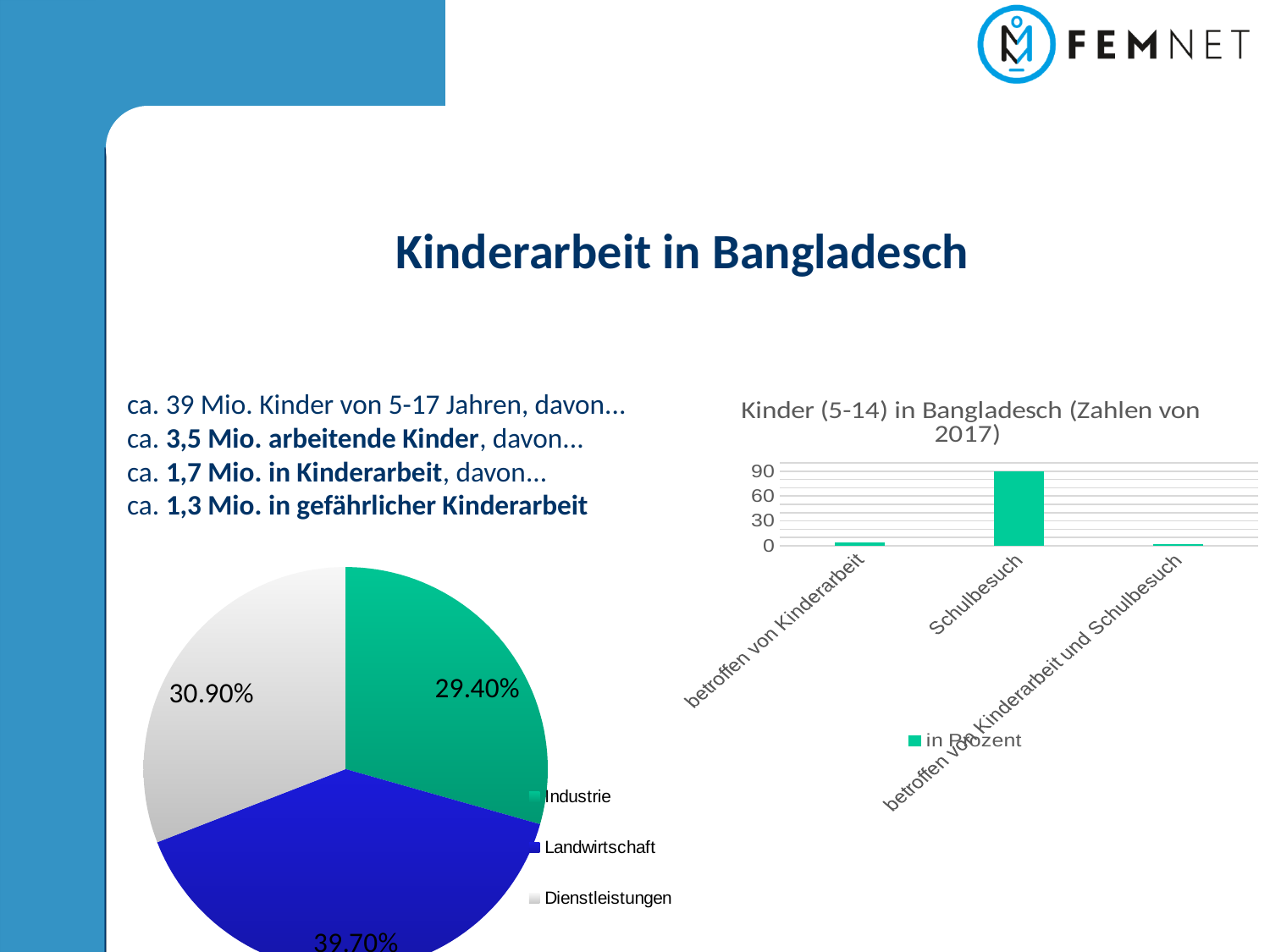
How many slices does the pie chart on the left have? 3 In the pie chart on the left, what percentage is shown for Landwirtschaft? 39.70% In the pie chart on the left, which category has the smallest share? Industrie What kind of chart is the chart on the left of the slide? Pie chart In the pie chart on the left, what is the difference between the shares of Landwirtschaft and Dienstleistungen? 8.80% In the pie chart on the left, which category has the largest share? Landwirtschaft In the chart 'Kinder (5-14) in Bangladesch (Zahlen von 2017)', is the value for Schulbesuch greater or less than 60? greater How many series does the legend of the chart 'Kinder (5-14) in Bangladesch (Zahlen von 2017)' list? 1 In the pie chart on the left, what percentage is shown for Industrie? 29.40% What kind of chart is 'Kinder (5-14) in Bangladesch (Zahlen von 2017)'? Bar chart In the chart 'Kinder (5-14) in Bangladesch (Zahlen von 2017)', which category has the highest value? Schulbesuch In the chart 'Kinder (5-14) in Bangladesch (Zahlen von 2017)', is the value for 'betroffen von Kinderarbeit' greater or less than 30? less